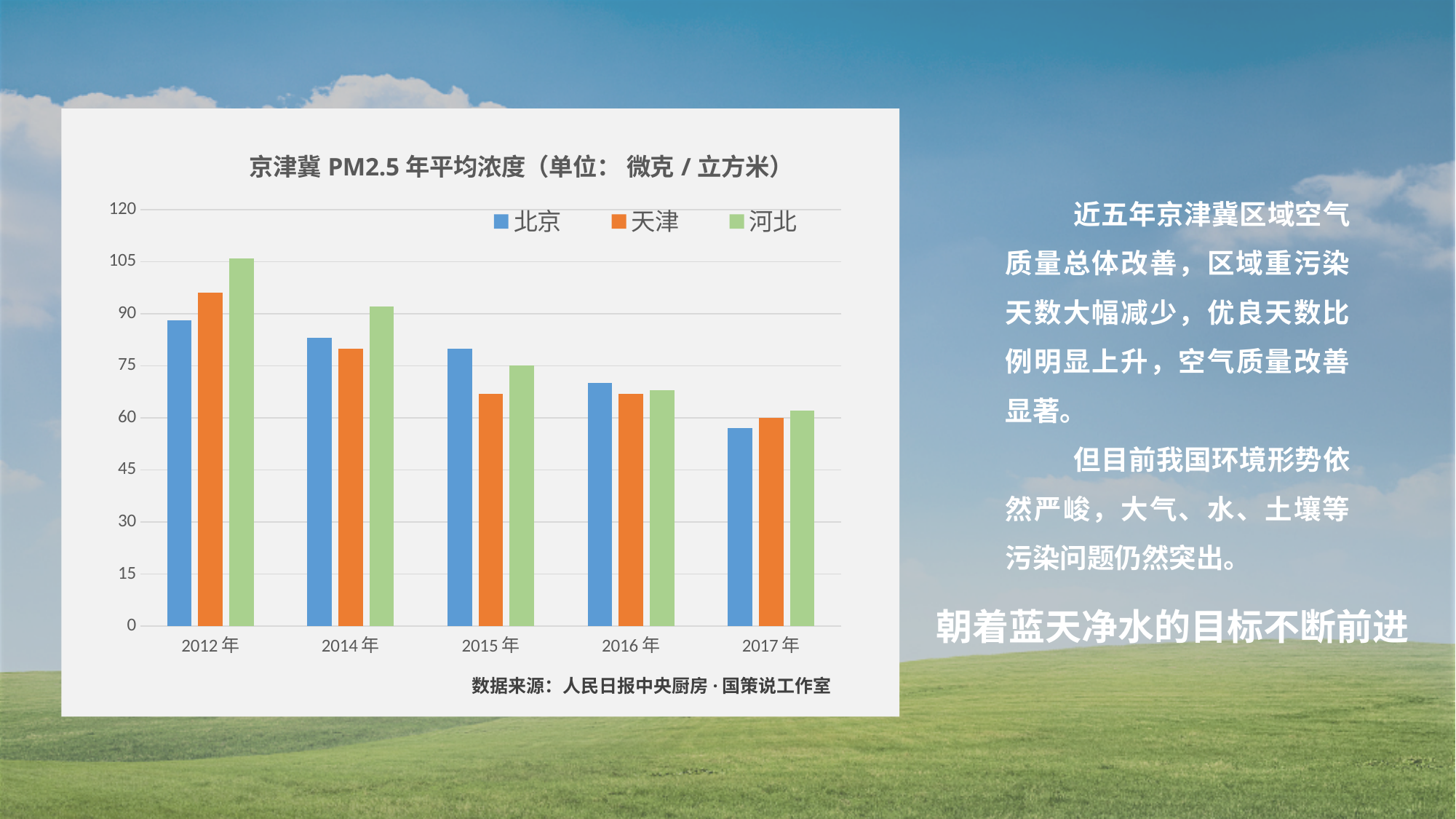
Which region has the lowest bar in 2012年? 北京 Is the value for 天津 in 2015年 greater or less than 75? less How many series does the legend list? 3 What kind of chart is shown on the slide? bar chart Is the value for 天津 in 2012年 greater or less than 90? greater Does the value for 北京 rise or fall from 2012年 to 2017年? fall How many years are shown on the x axis? 5 Is the value for 河北 in 2012年 greater or less than 90? greater In 2015年, which is larger, the value for 北京 or for 河北? 北京 Which colour represents 北京 in the legend? blue Which region has the highest bar in 2012年? 河北